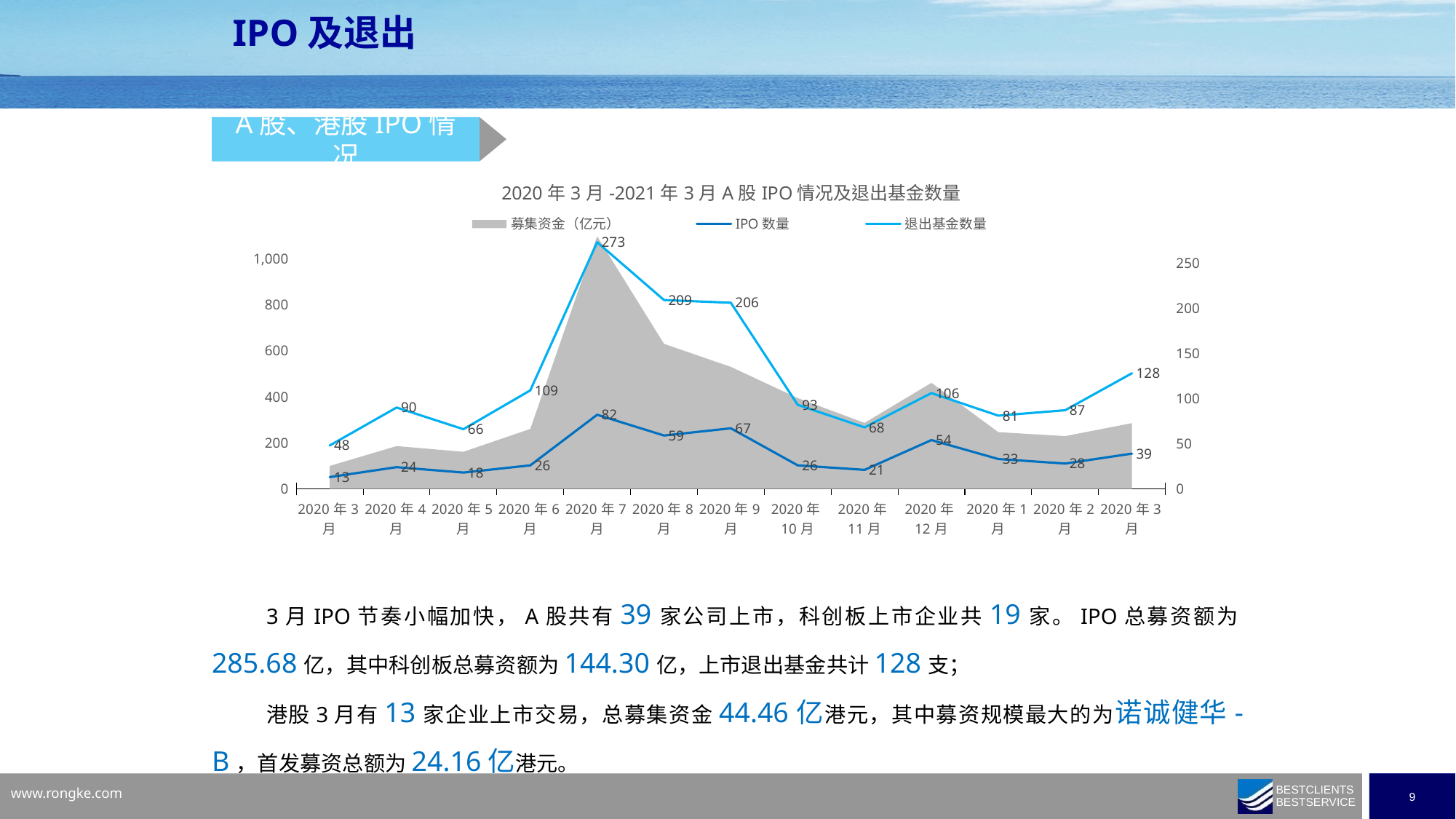
What is the IPO 数量 value for 2020 年 7 月? 82 What is the lowest IPO 数量 value shown on the chart? 13 How many months (categories) are plotted along the x axis? 13 Which month has the larger IPO 数量 value, 2020 年 8 月 or 2020 年 9 月? 2020 年 9 月 In which month does 退出基金数量 reach its highest value? 2020 年 7 月 What is the IPO 数量 value for 2020 年 12 月? 54 How many series does the chart legend list? 3 What kind of chart is shown on the slide? A combined area and line chart Is the 募集资金（亿元） value for 2020 年 8 月 greater or less than 400? greater Does 退出基金数量 rise or fall from 2020 年 7 月 to 2020 年 11 月? fall What is the difference between the 退出基金数量 values for 2020 年 8 月 and 2020 年 9 月? 3 What is the 退出基金数量 value for 2020 年 7 月? 273